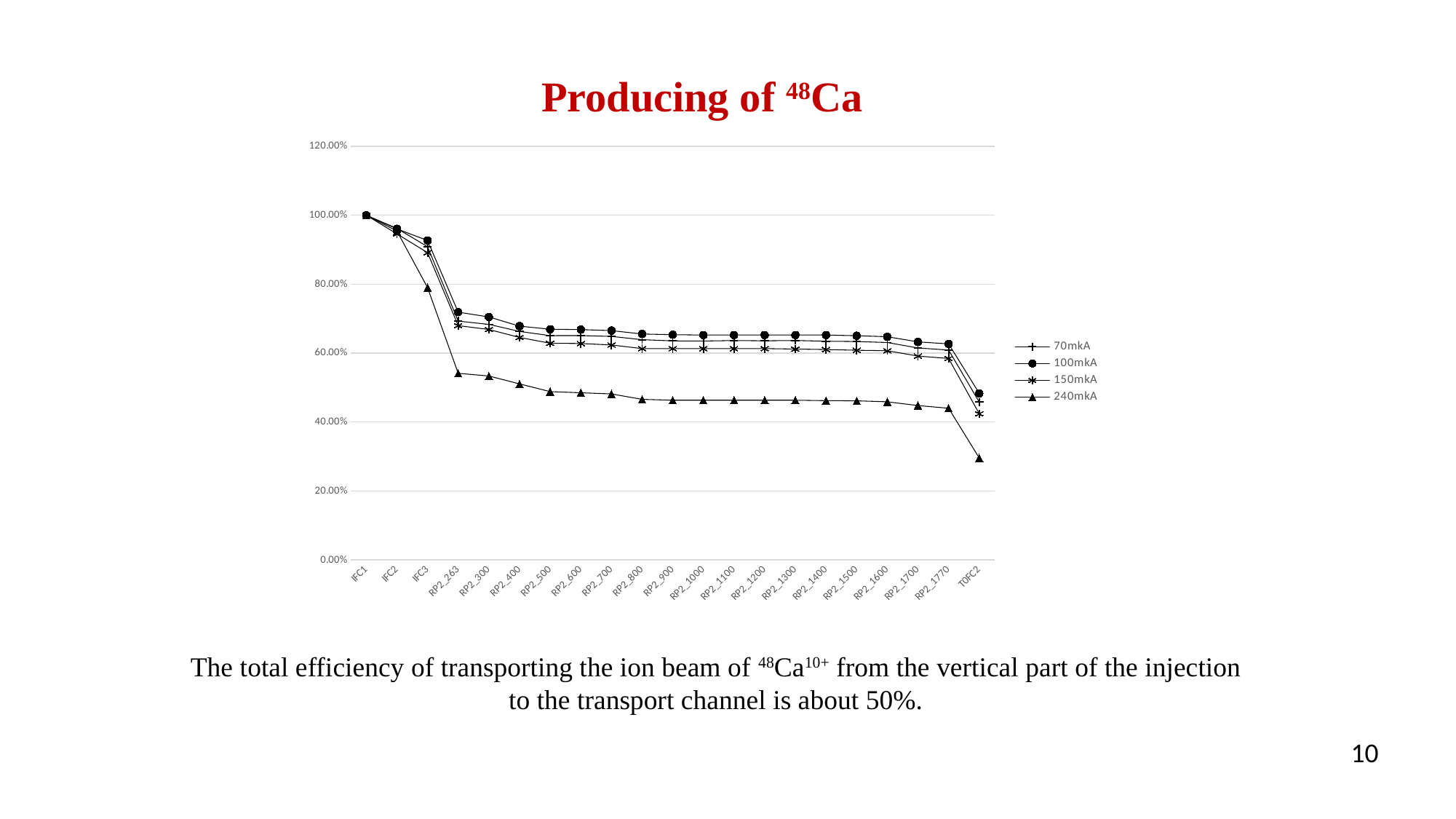
How many series does the legend list? 4 Is the value of the 100mkA series at RP2_500 greater or less than 60.00%? greater Do the values of the 240mkA series rise or fall from IFC1 to T0FC2? fall Which series has the lowest value at T0FC2? 240mkA Which series is drawn with triangle markers? 240mkA Is the value of the 240mkA series at RP2_1000 greater or less than 60.00%? less What is the value of the 100mkA series at IFC1? 100.00% Is the value of the 240mkA series at T0FC2 greater or less than 40.00%? less Which series has the highest value at RP2_1000? 100mkA Which is larger at RP2_263: the 100mkA series or the 240mkA series? 100mkA What kind of chart is shown on the slide? line chart How many categories are plotted along the x axis? 21